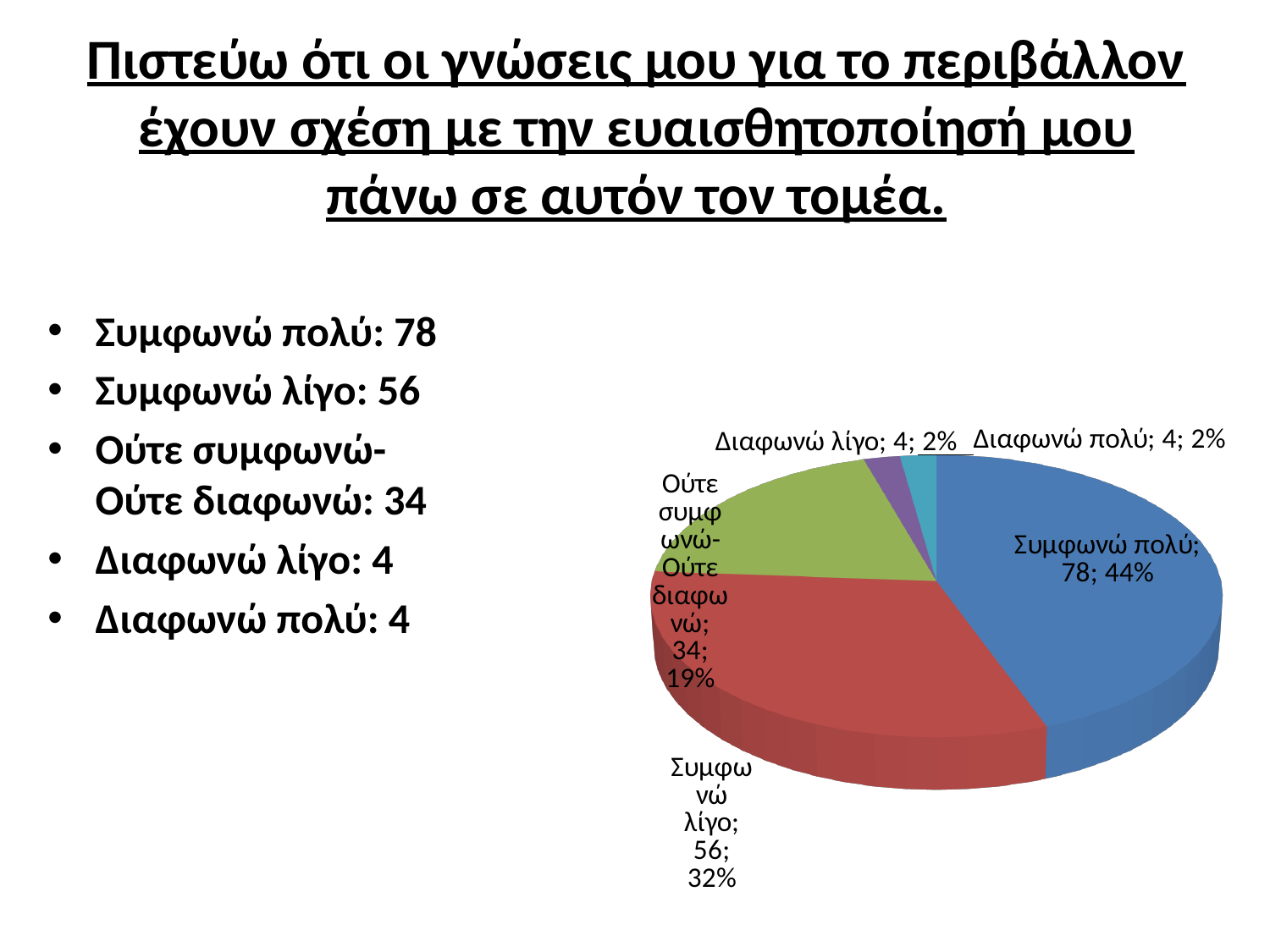
What is the difference between the values for Συμφωνώ πολύ and Συμφωνώ λίγο? 22 What kind of chart is shown on the slide? pie chart Which category has the largest slice in the pie chart? Συμφωνώ πολύ How many slices does the pie chart have? 5 What is the total of all the values shown in the pie chart? 176 What share of the pie does Συμφωνώ πολύ represent? 44% What is the value for Διαφωνώ λίγο in the pie chart? 4 Which is larger, the value for Συμφωνώ λίγο or the value for Ούτε συμφωνώ-Ούτε διαφωνώ? Συμφωνώ λίγο What is the value for Συμφωνώ λίγο in the pie chart? 56 What is the value for Ούτε συμφωνώ-Ούτε διαφωνώ in the pie chart? 34 What is the value for Συμφωνώ πολύ in the pie chart? 78 What share of the pie does Ούτε συμφωνώ-Ούτε διαφωνώ represent? 19%